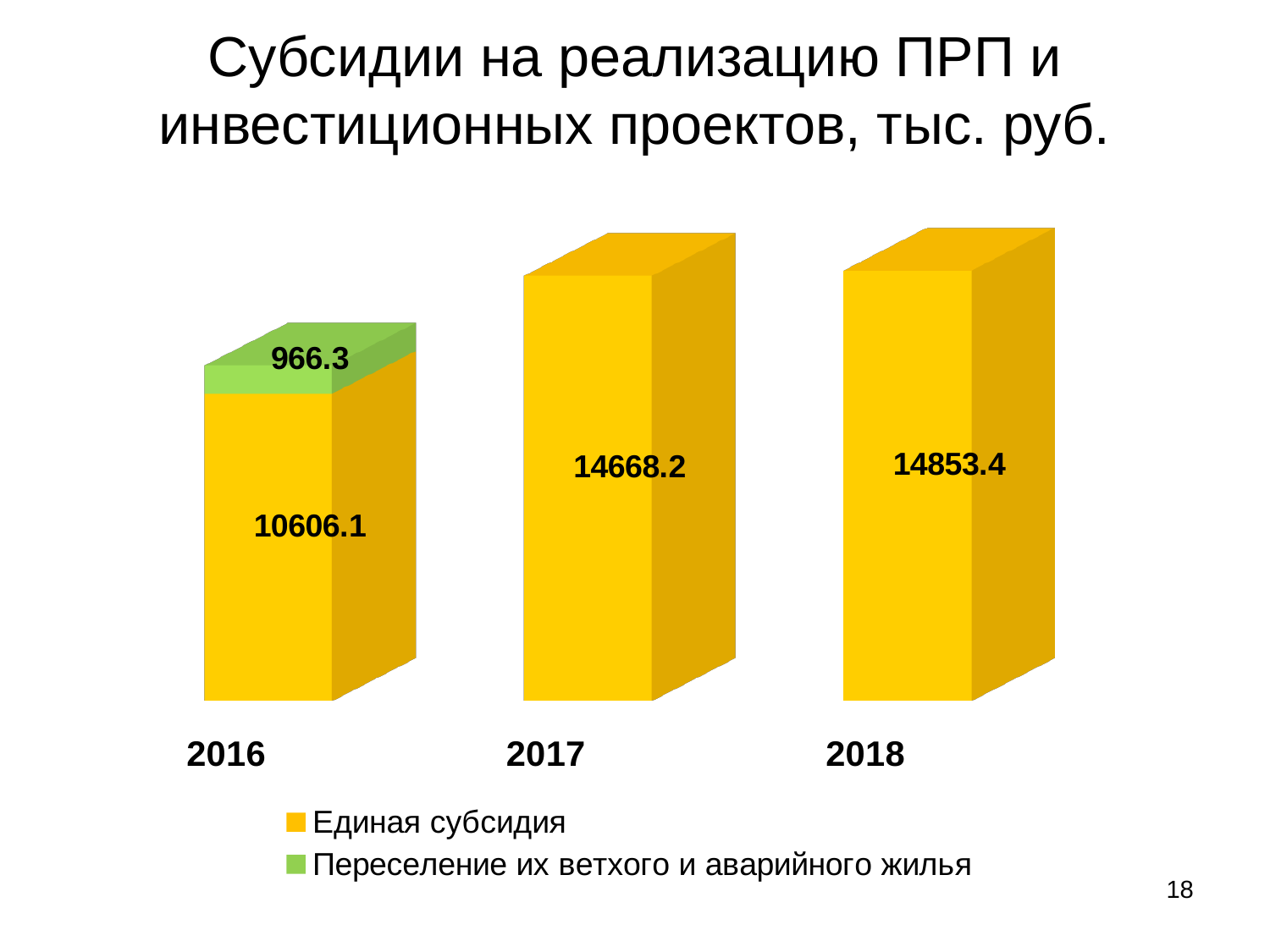
How many series does the legend list? 2 What is the value of Единая субсидия for 2018? 14853.4 What is the value of Единая субсидия for 2016? 10606.1 What is the value of Единая субсидия for 2017? 14668.2 Which year has the highest value of Единая субсидия? 2018 How many years are shown on the x axis? 3 Does the value of Единая субсидия rise or fall from 2016 to 2018? rise What is the value of Переселение их ветхого и аварийного жилья for 2016? 966.3 What is the difference between the Единая субсидия values for 2017 and 2016? 4062.1 Which year has the lowest value of Единая субсидия? 2016 What is the total of the stacked bar for 2016? 11572.4 What is the difference between the Единая субсидия values for 2018 and 2017? 185.2